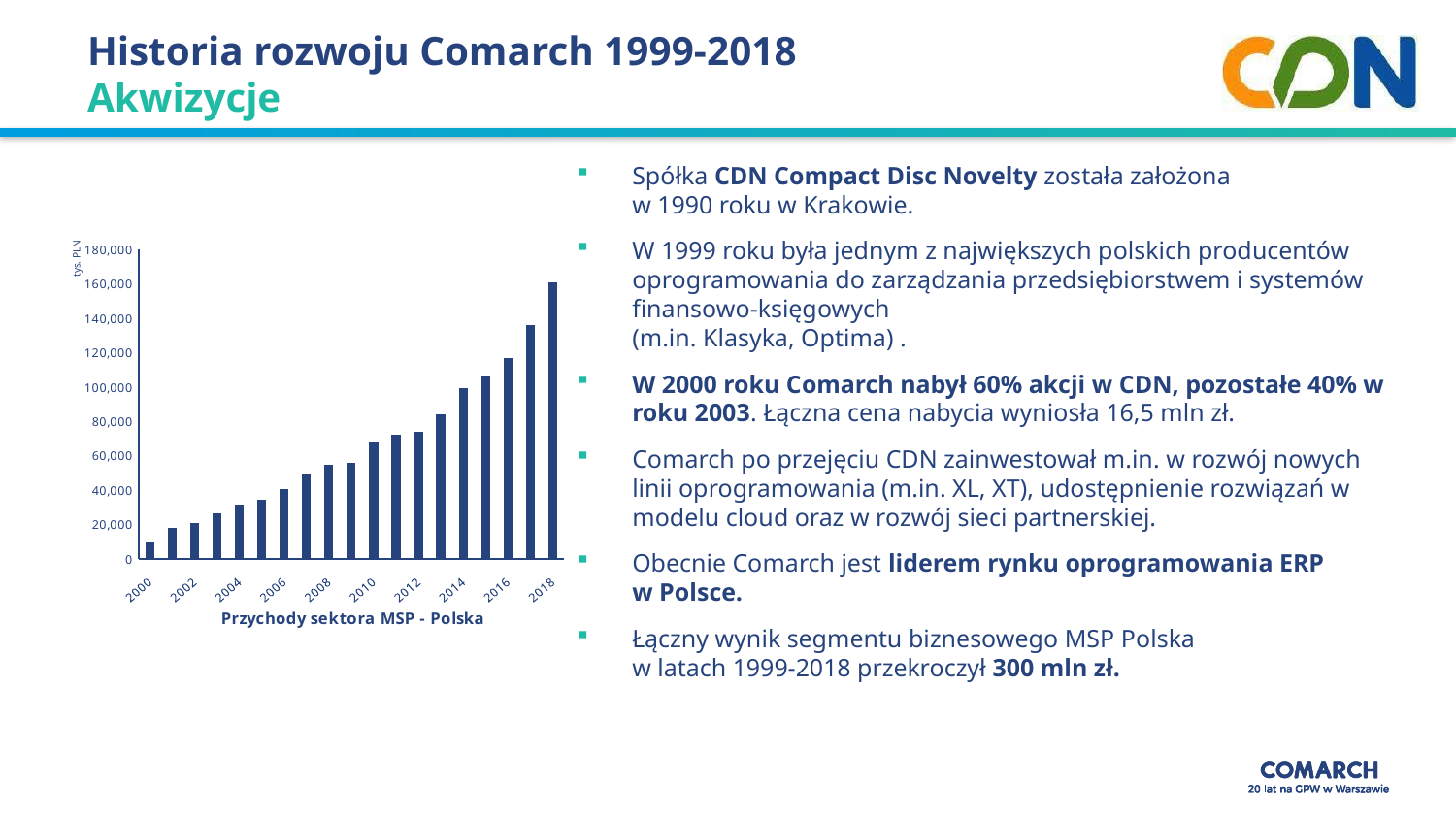
Which year has the larger value, 2008 or 2014? 2014 Which year has the highest value in the chart? 2018 What is the title of the chart? Przychody sektora MSP - Polska What kind of chart is shown on the slide? bar chart Do the values in the chart generally rise or fall from 2000 to 2018? rise Is the value for 2010 greater or less than 60,000? greater Is the value for 2000 greater or less than 20,000? less Which year has the lowest value in the chart? 2000 Is the value for 2018 greater or less than 140,000? greater What unit is shown on the y-axis of the chart? tys. PLN